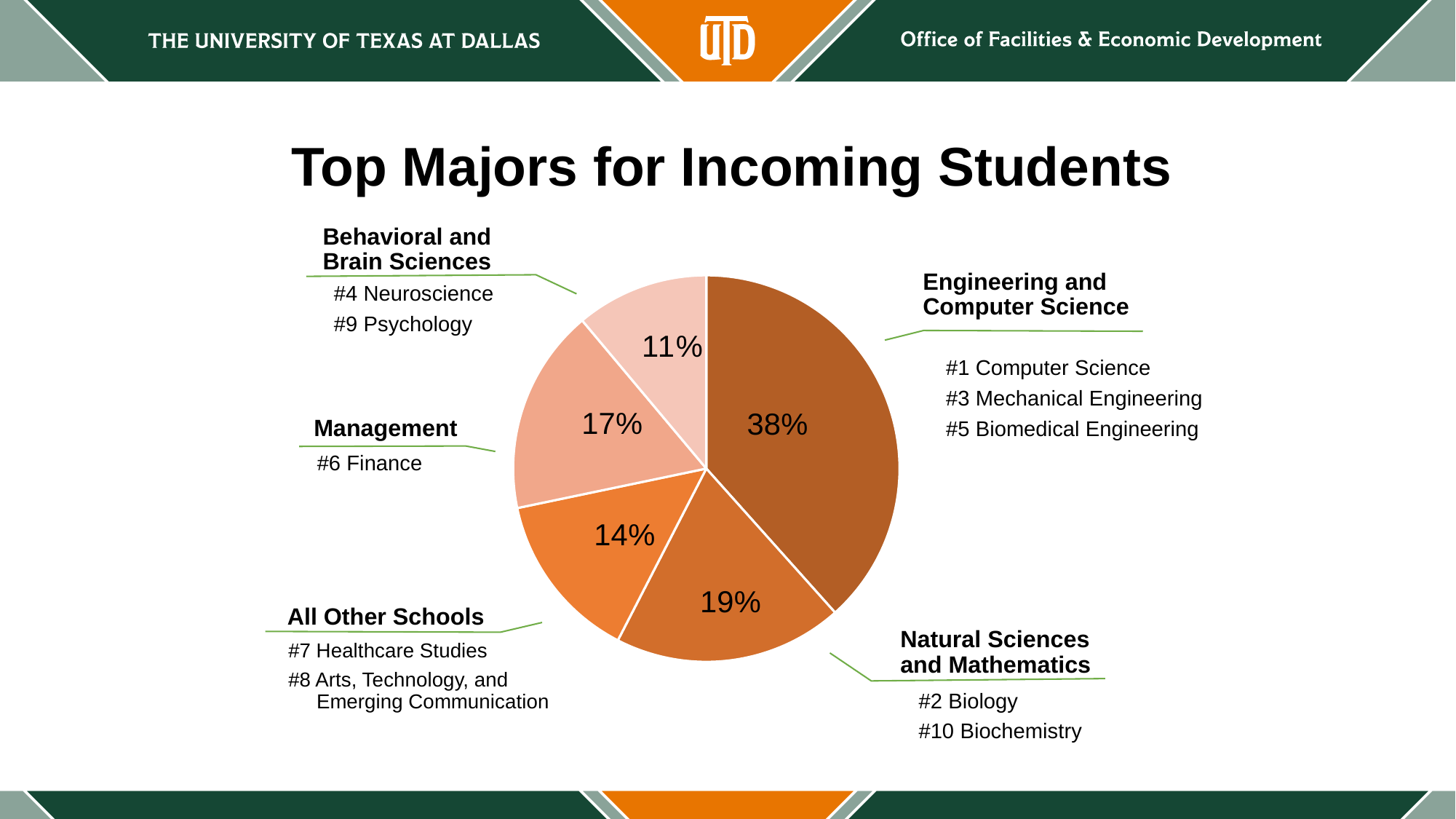
Which school has the smallest slice of the pie? Behavioral and Brain Sciences How many slices does the pie chart have? 5 What percentage is shown for Natural Sciences and Mathematics? 19% What percentage is shown for Behavioral and Brain Sciences? 11% Which is larger, the share for Management or the share for All Other Schools? Management What is the title of the slide containing the chart? Top Majors for Incoming Students What share of the pie does Engineering and Computer Science hold? 38% Which school has the largest slice of the pie? Engineering and Computer Science What is the difference in percentage points between Engineering and Computer Science and Natural Sciences and Mathematics? 19 What type of chart is shown on the slide? Pie chart What percentage is shown for Management? 17% What percentage is shown for All Other Schools? 14%